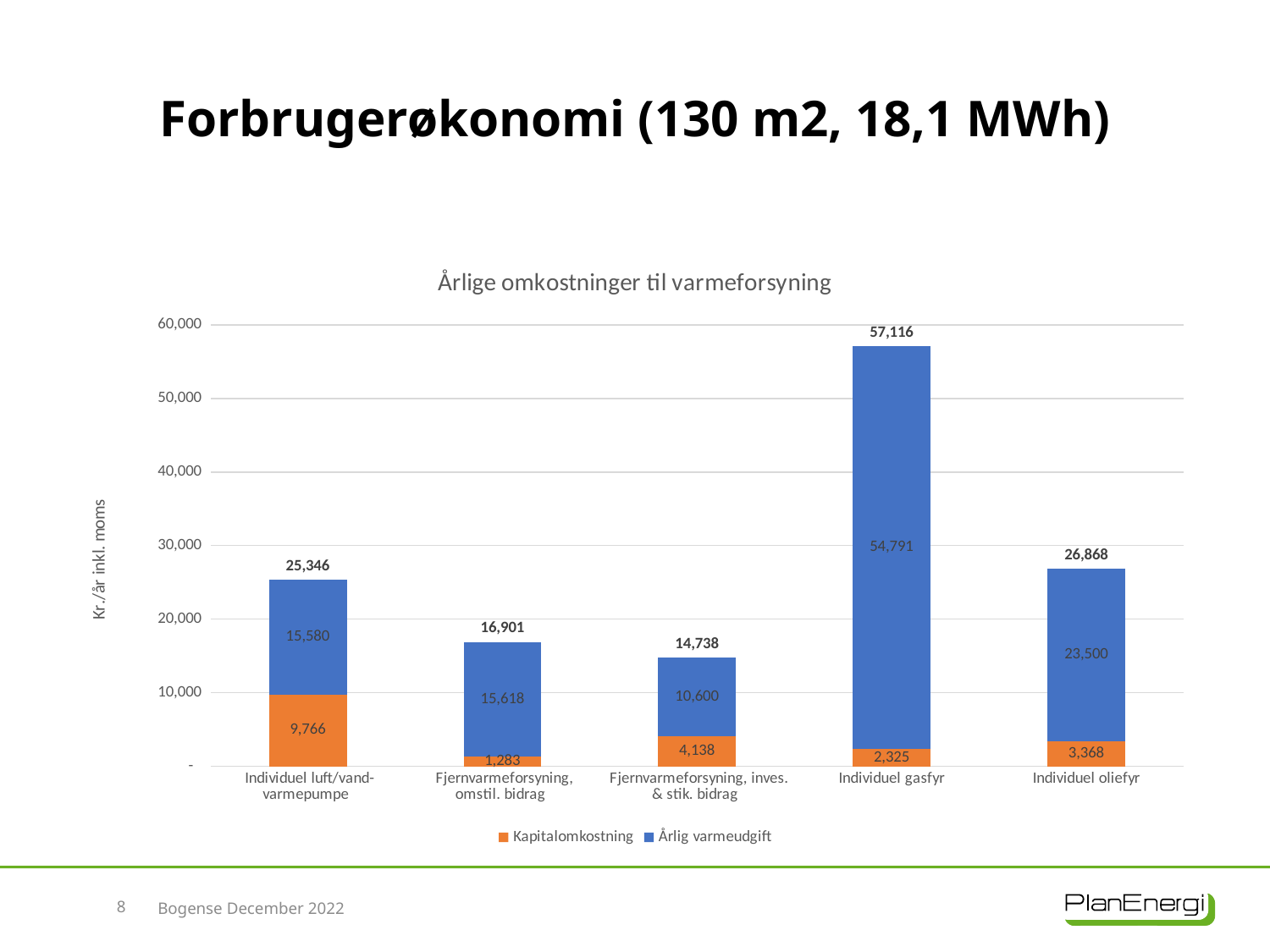
What is the Kapitalomkostning value for Individuel luft/vand-varmepumpe? 9,766 Which category has the lowest total annual cost? Fjernvarmeforsyning, inves. & stik. bidrag What is the difference between the total for Individuel oliefyr and the total for Individuel luft/vand-varmepumpe? 1,522 How many categories are shown on the x axis? 5 Which category has the highest total annual cost? Individuel gasfyr What type of chart is shown on the slide? Stacked bar chart How many series does the legend list? 2 What is the total annual cost shown for Fjernvarmeforsyning, inves. & stik. bidrag? 14,738 What is the Kapitalomkostning value for Fjernvarmeforsyning, omstil. bidrag? 1,283 What is the Årlig varmeudgift value for Individuel gasfyr? 54,791 What is the Årlig varmeudgift value for Individuel oliefyr? 23,500 What is the total annual cost shown for Individuel gasfyr? 57,116